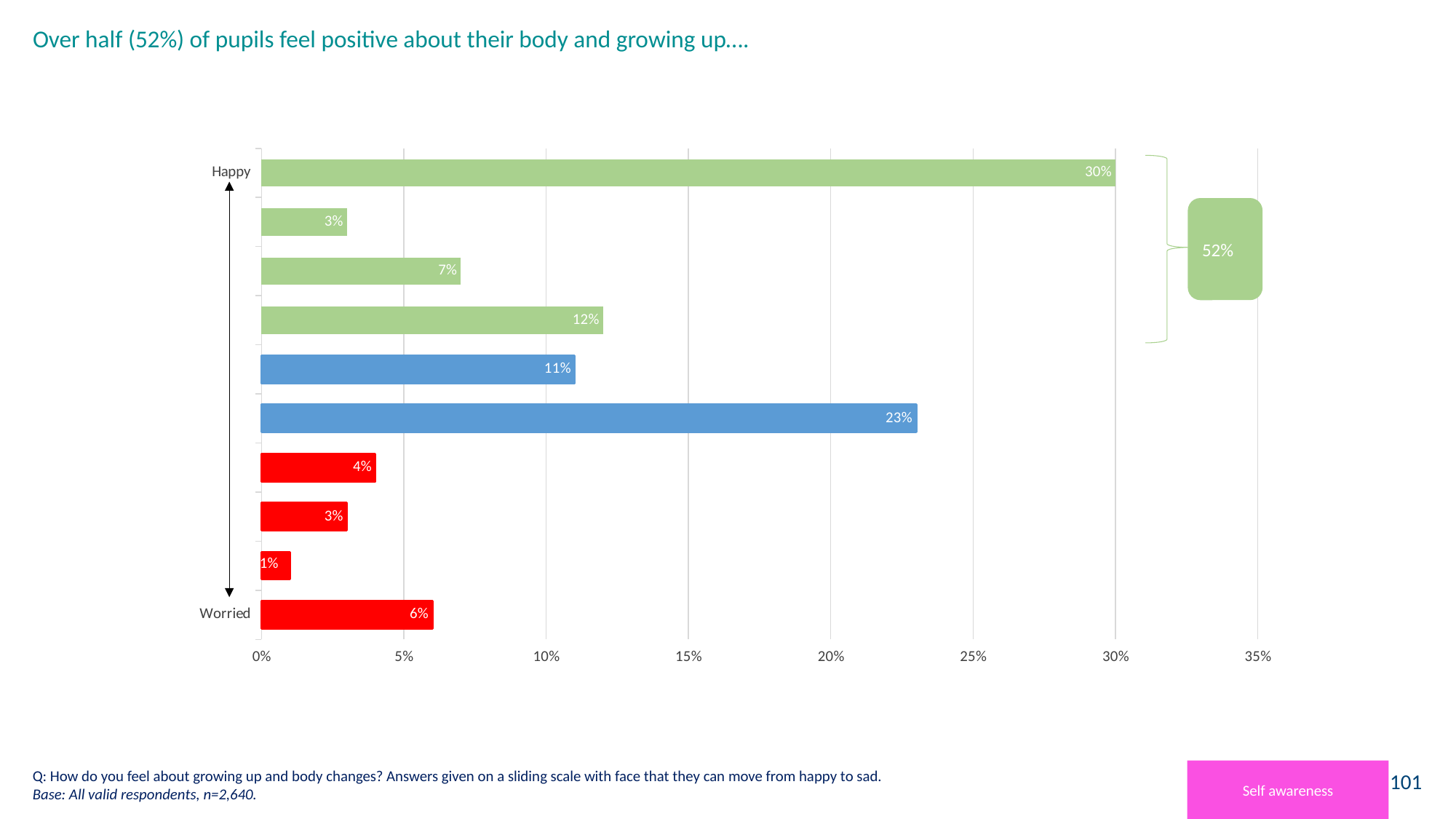
What is the value of the bar labelled "Happy" at the top of the chart? 30% What is the value of the longest blue bar in the chart? 23% What is the total of the four green bars, as shown in the callout next to the chart? 52% Which bar has the highest value in the chart? Happy (30%) How many bars are plotted in the chart? 10 Which is larger, the "Happy" bar or the "Worried" bar? Happy What percentage is shown in the green rounded box to the right of the chart? 52% Is the value of the "Happy" bar greater or less than 25%? greater What is the value of the bar labelled "Worried" at the bottom of the chart? 6% What is the lowest value shown on any bar in the chart? 1% What type of chart is shown on the slide? bar chart What is the difference between the "Happy" bar and the "Worried" bar? 24 percentage points